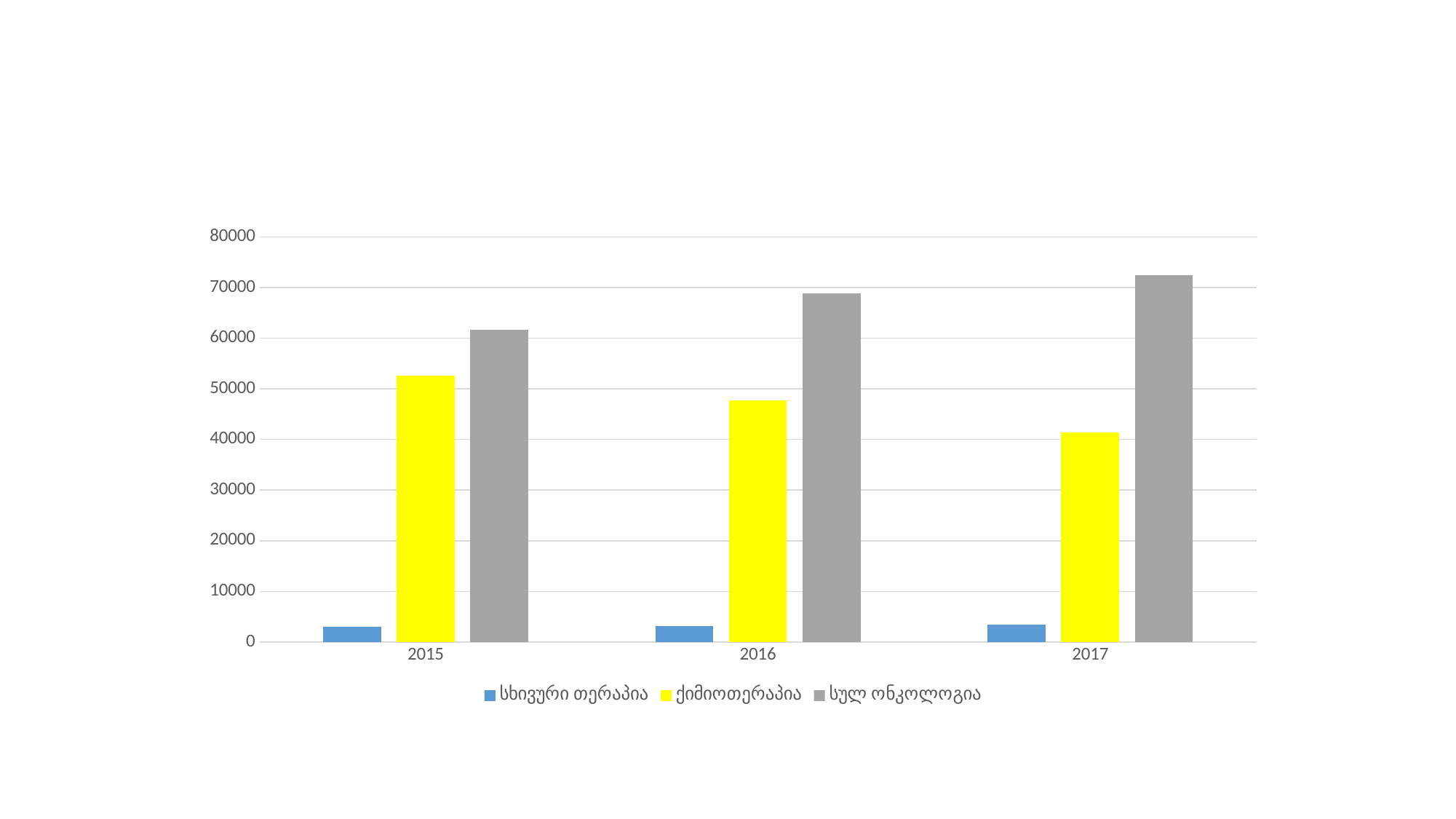
Is the value for ქიმიოთერაპია in 2015 greater or less than 50000? greater In which year is the value for სულ ონკოლოგია highest? 2017 How many series does the chart's legend list? 3 In which year is the value for ქიმიოთერაპია highest? 2015 Is the value for სულ ონკოლოგია in 2017 greater or less than 70000? greater Is the value for სხივური თერაპია in 2016 greater or less than 10000? less Does the value for სულ ონკოლოგია rise or fall from 2015 to 2017? rise How many years are shown on the x axis of the chart? 3 Which series is shown in grey in the chart? სულ ონკოლოგია In which year is the value for ქიმიოთერაპია lowest? 2017 What kind of chart is shown on the slide? bar chart Which series is shown in yellow in the chart? ქიმიოთერაპია